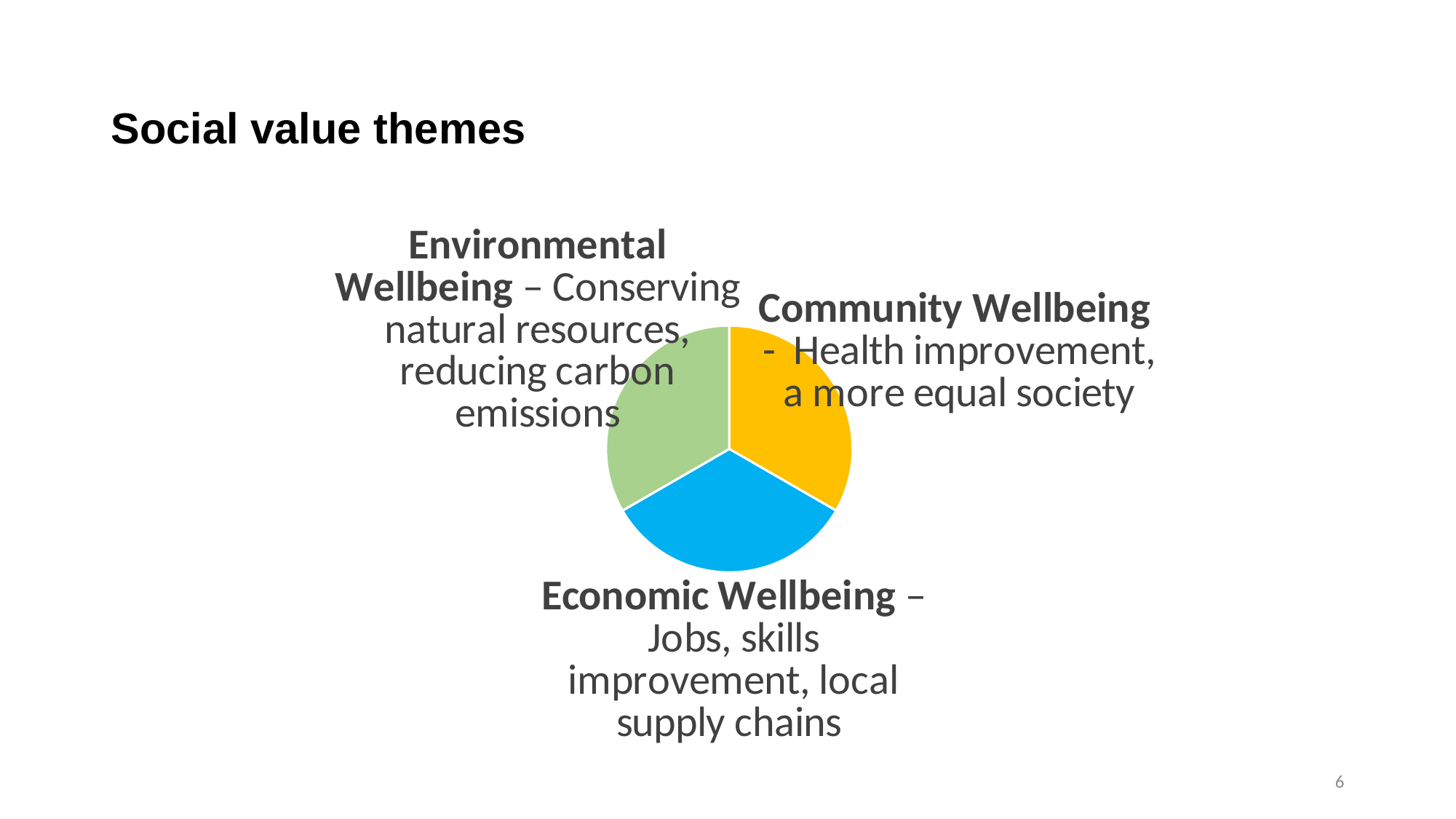
Which theme in the pie chart is described as 'Conserving natural resources, reducing carbon emissions'? Environmental Wellbeing Which theme in the pie chart is described as 'Health improvement, a more equal society'? Community Wellbeing Which theme in the pie chart is described as 'Jobs, skills improvement, local supply chains'? Economic Wellbeing Which theme does the green slice of the pie chart represent? Environmental Wellbeing Which theme does the yellow slice of the pie chart represent? Community Wellbeing How many social value themes are labelled around the pie chart? 3 What kind of chart is shown on the slide? Pie chart How many slices does the pie chart have? 3 What is the title of the slide containing the pie chart? Social value themes Which colour is the Economic Wellbeing slice of the pie chart? Blue